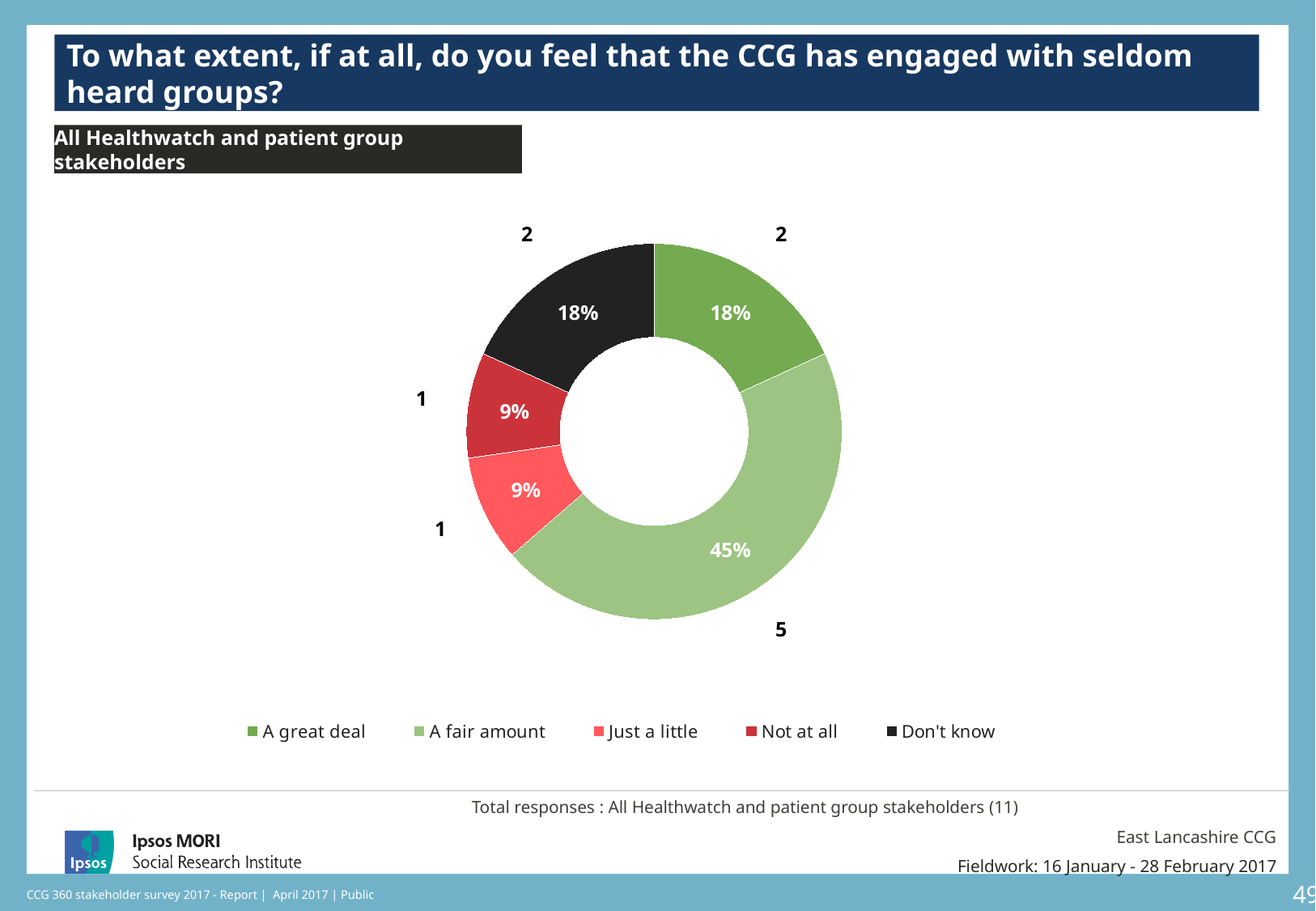
What kind of chart is shown on the slide? Doughnut chart What is the total number of responses shown for All Healthwatch and patient group stakeholders? 11 What percentage of respondents answered 'Not at all'? 9% What is the difference in percentage points between 'A fair amount' and 'Don't know'? 27 What percentage of respondents said the CCG has engaged with seldom heard groups 'A fair amount'? 45% Which response category has the largest share of the chart? A fair amount How many respondents answered 'Just a little'? 1 Which is larger, the share for 'A great deal' or the share for 'Just a little'? A great deal How many respondents answered 'A fair amount'? 5 Which colour represents 'Don't know' in the chart? Black How many response categories are shown in the chart? 5 What percentage of respondents answered 'A great deal'? 18%